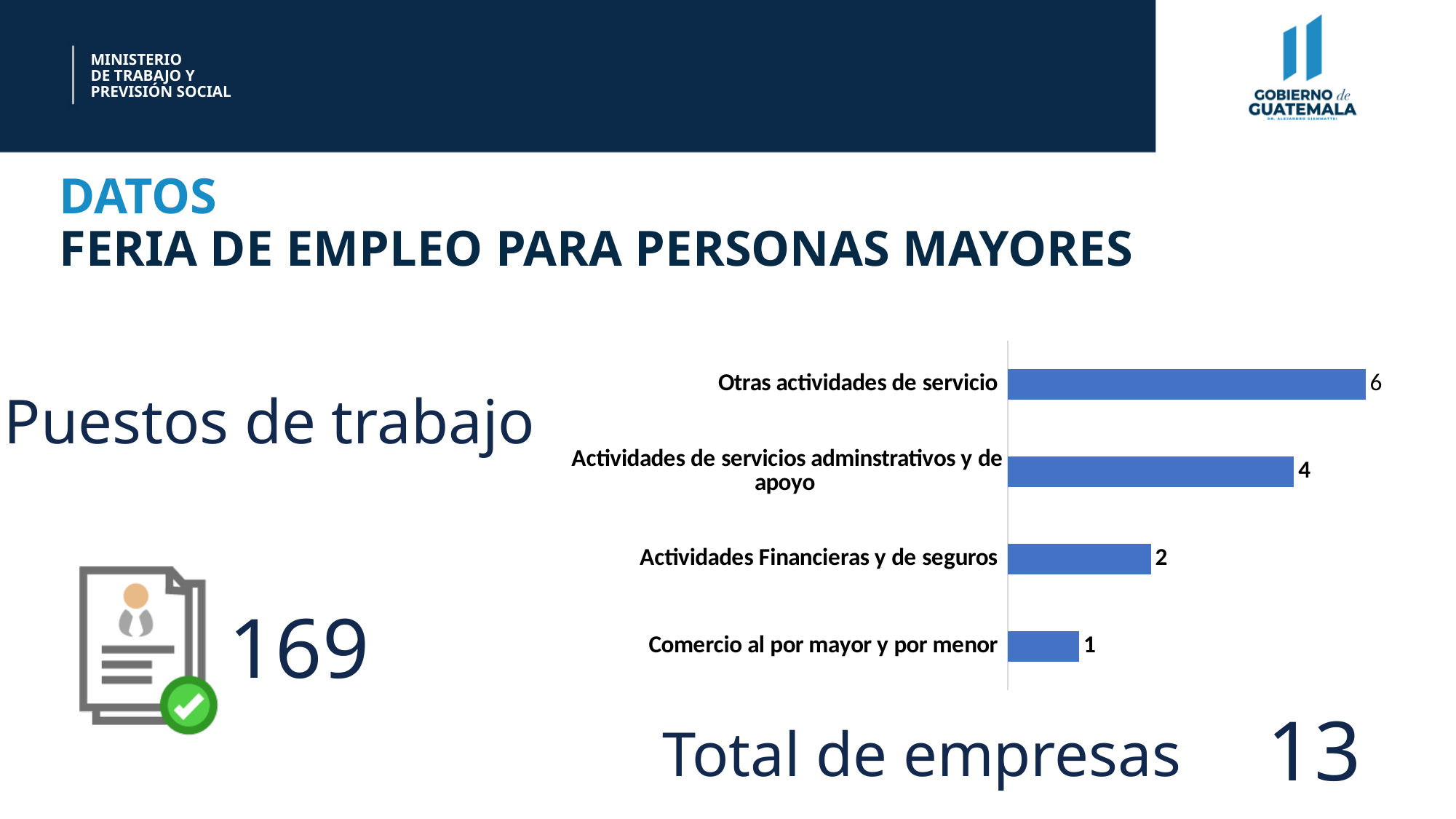
What is the difference between Actividades de servicios adminstrativos y de apoyo and Comercio al por mayor y por menor? 3 Which category has the lowest value? Comercio al por mayor y por menor What kind of chart is shown on the slide? bar chart What is the value for Comercio al por mayor y por menor? 1 What is the value for Otras actividades de servicio? 6 What is the value for Actividades de servicios adminstrativos y de apoyo? 4 Which category has the highest value? Otras actividades de servicio What is the difference between Otras actividades de servicio and Actividades Financieras y de seguros? 4 What colour are the bars in the chart? blue Which is larger: Actividades de servicios adminstrativos y de apoyo or Actividades Financieras y de seguros? Actividades de servicios adminstrativos y de apoyo What is the value for Actividades Financieras y de seguros? 2 How many categories are shown in the chart? 4